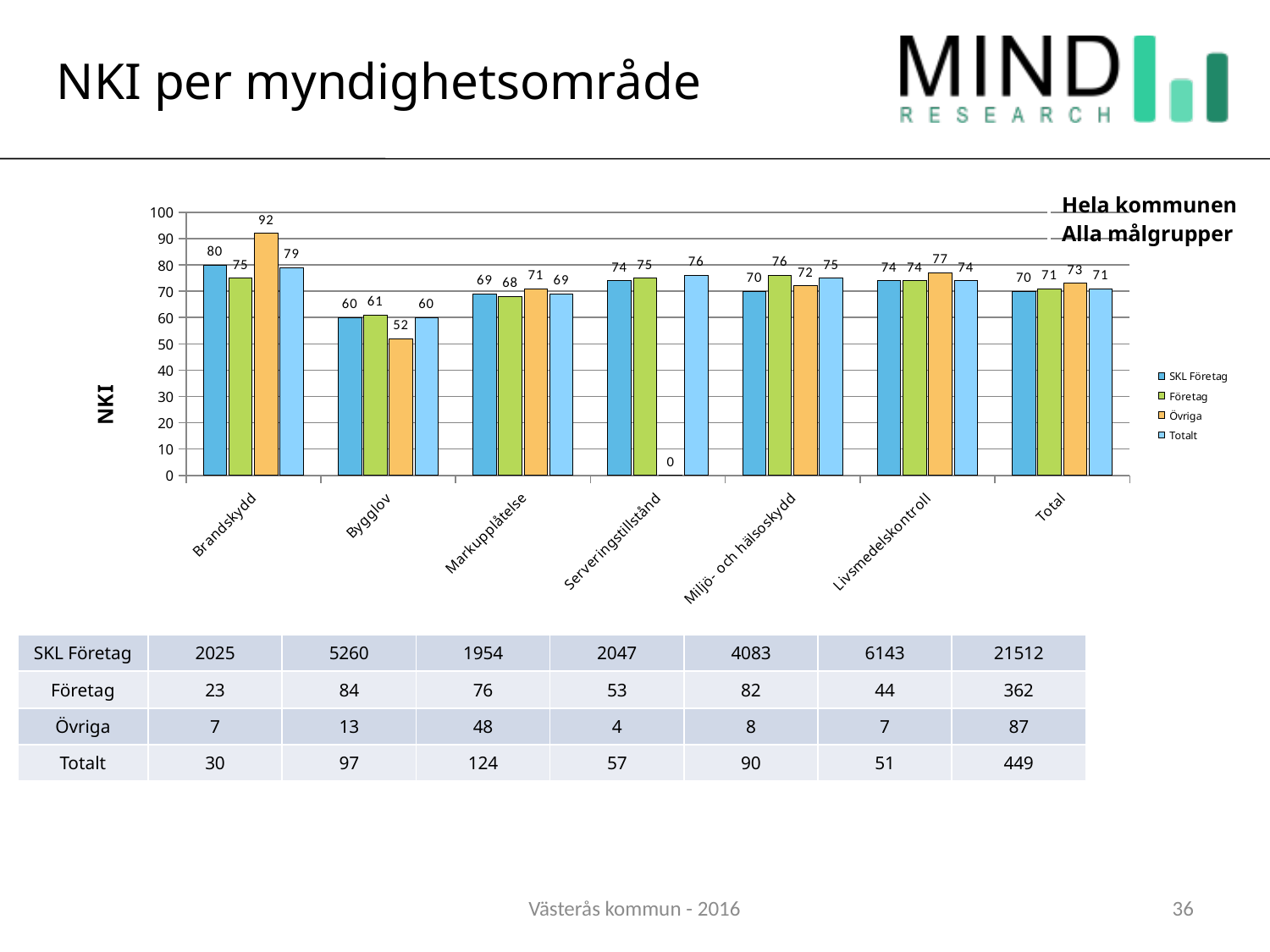
What is the label of the y axis of the chart? NKI Which is larger in Bygglov: the Företag value or the Övriga value? Företag How many categories are shown on the x axis of the chart? 7 What is the NKI value for SKL Företag in Bygglov? 60 What is the NKI value for Företag in Miljö- och hälsoskydd? 76 What is the NKI value for Totalt in Serveringstillstånd? 76 How many series does the chart legend list? 4 Which category has the highest Övriga value? Brandskydd What is the NKI value for Övriga in Brandskydd? 92 What is the difference between the Övriga value and the SKL Företag value in Brandskydd? 12 Which category has the lowest Totalt value? Bygglov What kind of chart is shown on the slide? Bar chart